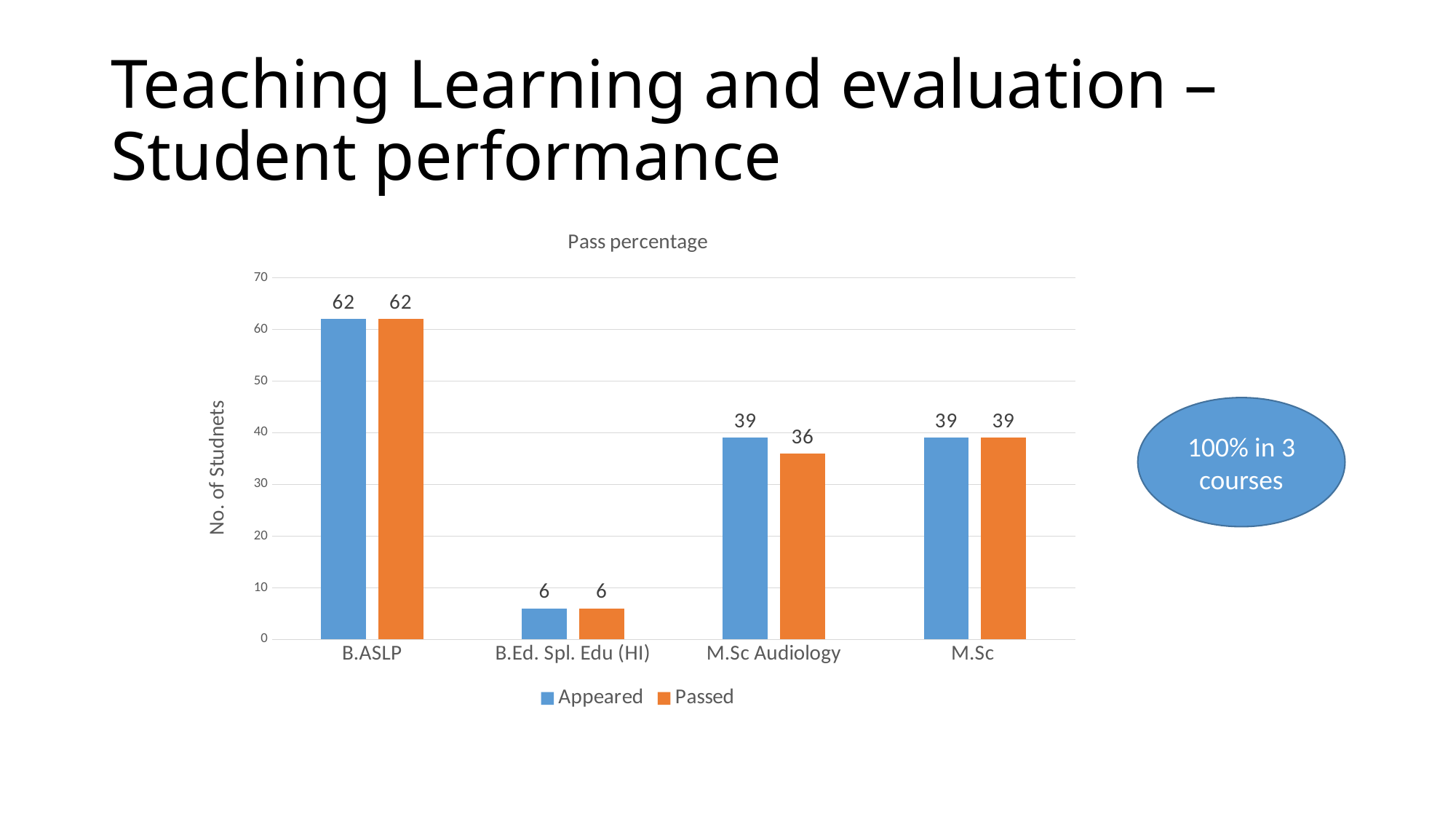
What is the label of the vertical axis? No. of Studnets How many courses are shown on the x axis of the chart? 4 How many students passed in M.Sc Audiology? 36 Which is larger for M.Sc Audiology: the number appeared or the number passed? Appeared Which course has the highest number of students appeared? B.ASLP How many students appeared for B.Ed. Spl. Edu (HI)? 6 What is the difference between the number appeared and the number passed for M.Sc Audiology? 3 Which course has the lowest number of students passed? B.Ed. Spl. Edu (HI) How many series does the legend list? 2 What is the number of students who appeared for B.ASLP? 62 What kind of chart is shown on the slide? Bar chart What is the title of the chart? Pass percentage